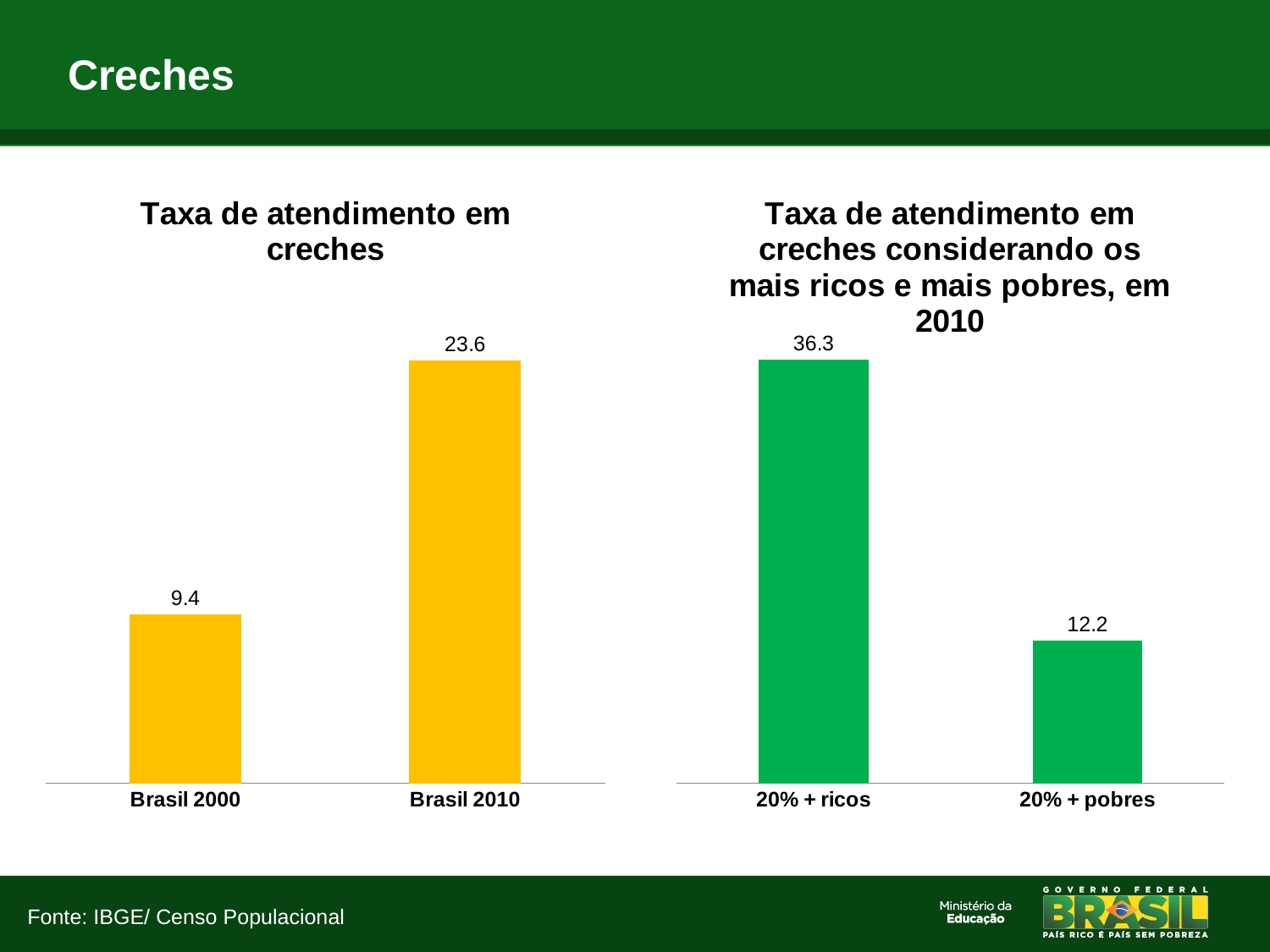
In the right chart 'Taxa de atendimento em creches considerando os mais ricos e mais pobres, em 2010', what is the difference between the values for 20% + ricos and 20% + pobres? 24.1 In the right chart 'Taxa de atendimento em creches considerando os mais ricos e mais pobres, em 2010', what is the value for 20% + ricos? 36.3 In the right chart 'Taxa de atendimento em creches considerando os mais ricos e mais pobres, em 2010', what is the value for 20% + pobres? 12.2 In the right chart 'Taxa de atendimento em creches considerando os mais ricos e mais pobres, em 2010', which is larger: the value for 20% + ricos or for 20% + pobres? 20% + ricos In the left chart 'Taxa de atendimento em creches', what is the value for Brasil 2000? 9.4 In the left chart 'Taxa de atendimento em creches', which category has the higher value? Brasil 2010 In the left chart 'Taxa de atendimento em creches', do the values rise or fall from Brasil 2000 to Brasil 2010? Rise In the left chart 'Taxa de atendimento em creches', what is the difference between the values for Brasil 2010 and Brasil 2000? 14.2 How many categories does the left chart 'Taxa de atendimento em creches' show? 2 In the left chart 'Taxa de atendimento em creches', what is the value for Brasil 2010? 23.6 In the right chart 'Taxa de atendimento em creches considerando os mais ricos e mais pobres, em 2010', which category has the lower value? 20% + pobres What kind of chart is the right chart 'Taxa de atendimento em creches considerando os mais ricos e mais pobres, em 2010'? Bar chart